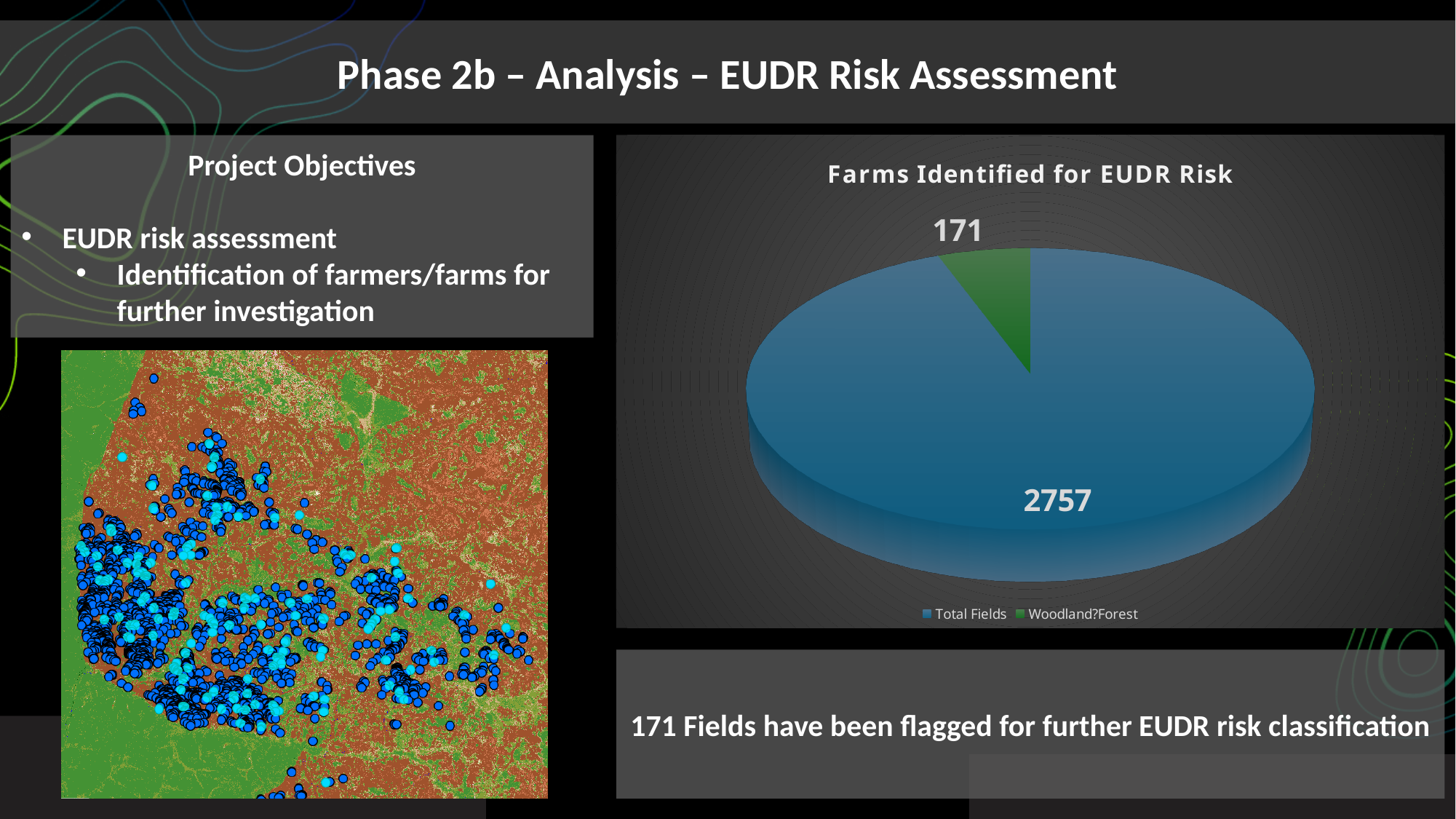
Which slice of the pie chart is the largest? Total Fields Which slice of the pie chart is the smallest? Woodland?Forest What value is shown for the Woodland?Forest slice in the pie chart? 171 What is the title of the pie chart? Farms Identified for EUDR Risk What value is shown for the Total Fields slice in the pie chart? 2757 Which is larger in the pie chart, Total Fields or Woodland?Forest? Total Fields What is the sum of the two values shown in the pie chart? 2928 How many entries does the legend of the pie chart list? 2 How many slices does the pie chart have? 2 What colour is the Woodland?Forest slice in the pie chart? Green What kind of chart is shown on the slide? Pie chart What is the difference between the Total Fields value and the Woodland?Forest value in the pie chart? 2586